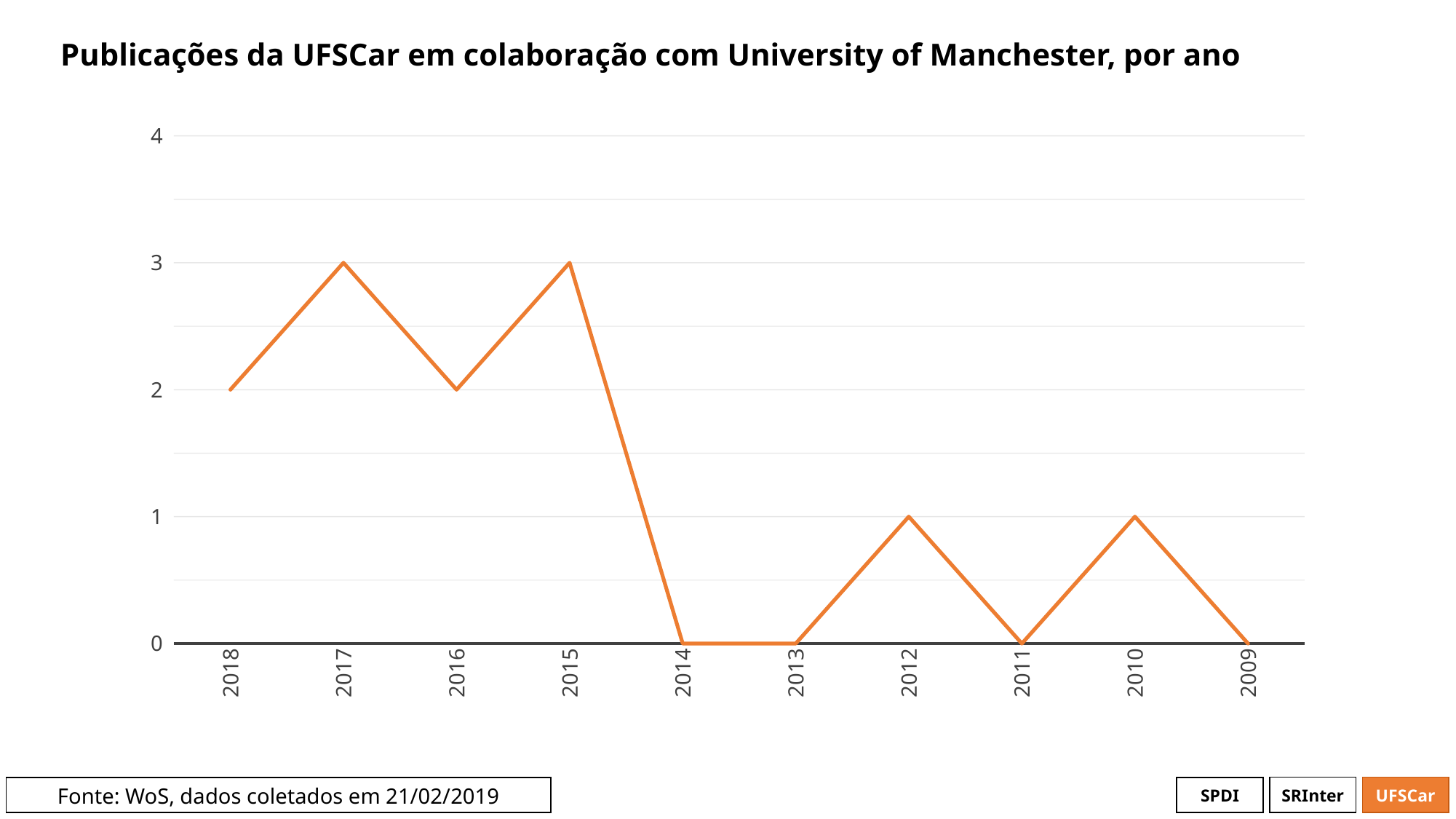
What is the value for 2012? 1 What is the value for 2015? 3 What kind of chart is shown on the slide? line chart What is the value for 2017? 3 What is the title of the chart? Publicações da UFSCar em colaboração com University of Manchester, por ano What is the highest value reached by the line? 3 Which year has the larger value, 2017 or 2016? 2017 Do the values generally rise or fall moving from left (2018) to right (2009) along the x axis? fall What is the value for 2018? 2 How many years are plotted on the x axis? 10 What is the difference between the values for 2017 and 2018? 1 What is the value for 2014? 0